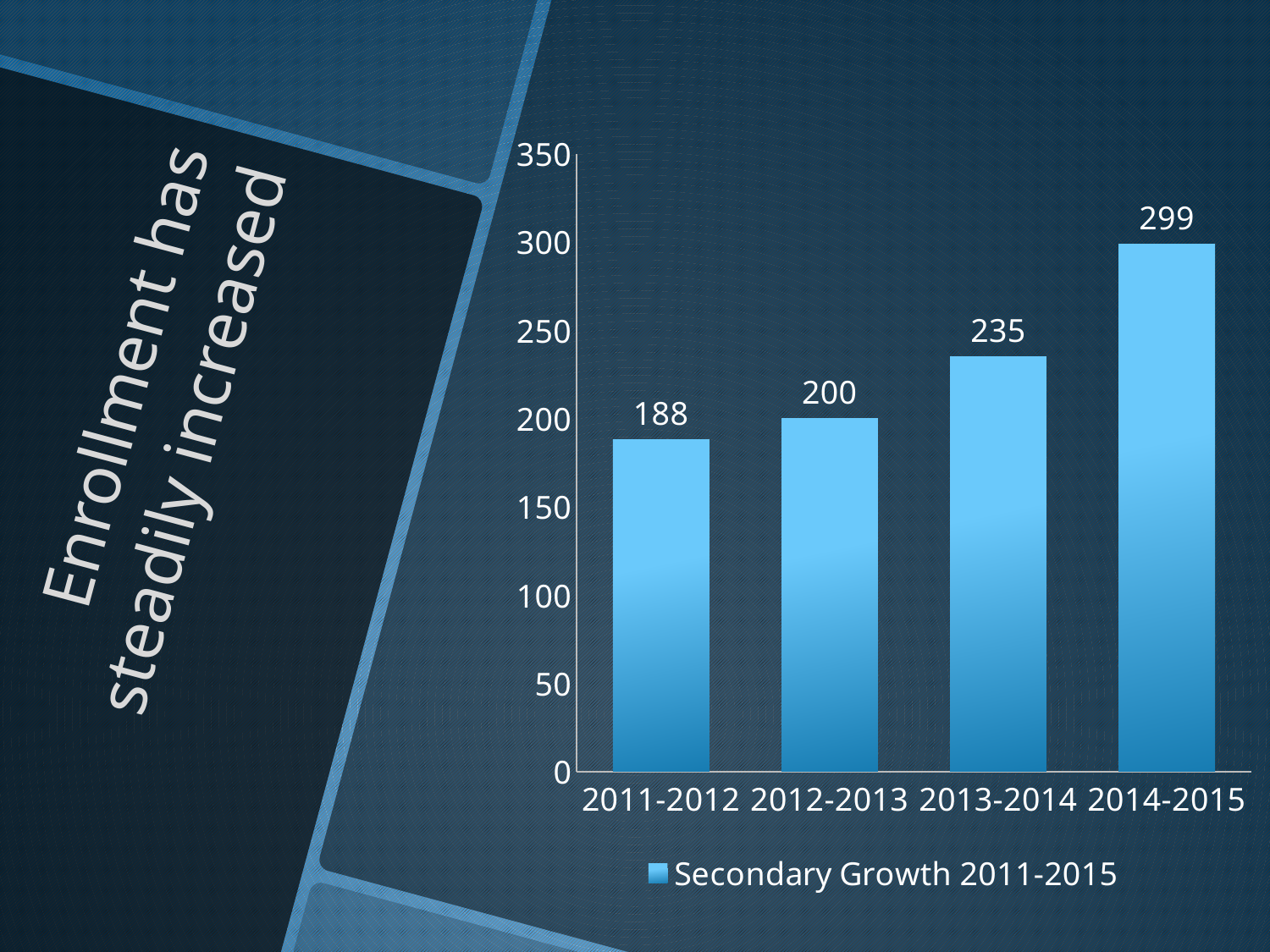
What is the value for 2014-2015? 299 Do the values rise or fall from 2011-2012 to 2014-2015? rise How many series does the legend list? 1 How many categories are shown on the x axis? 4 Which year has the highest value? 2014-2015 Which is larger, the value for 2013-2014 or the value for 2012-2013? 2013-2014 What kind of chart is shown? bar chart Which year has the lowest value? 2011-2012 What is the difference between the values for 2014-2015 and 2011-2012? 111 What is the value for 2012-2013? 200 What is the value for 2011-2012? 188 What is the value for 2013-2014? 235